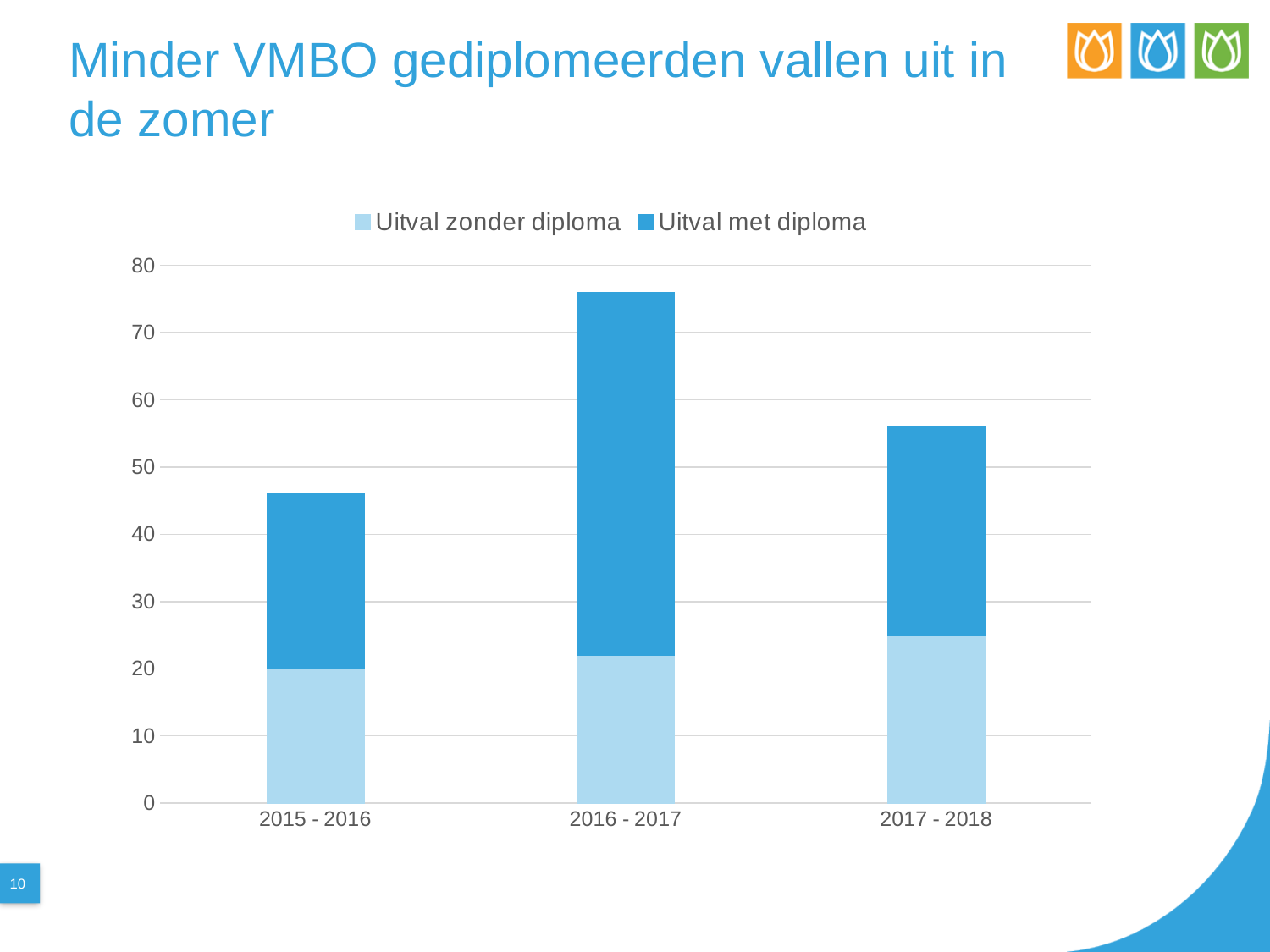
Is the total bar for 2016 - 2017 greater or less than 70? greater What kind of chart is shown on the slide? Stacked bar chart Which school year has the highest total bar? 2016 - 2017 Which legend entry is shown in the lighter blue colour? Uitval zonder diploma Which is larger, the total bar for 2016 - 2017 or the total bar for 2017 - 2018? 2016 - 2017 Which school year has the largest 'Uitval met diploma' segment? 2016 - 2017 Is the total bar for 2017 - 2018 greater or less than 50? greater Is the 'Uitval zonder diploma' value for 2017 - 2018 greater or less than 30? less How many series does the legend list? 2 How many school years are shown on the x axis? 3 Which school year has the lowest total bar? 2015 - 2016